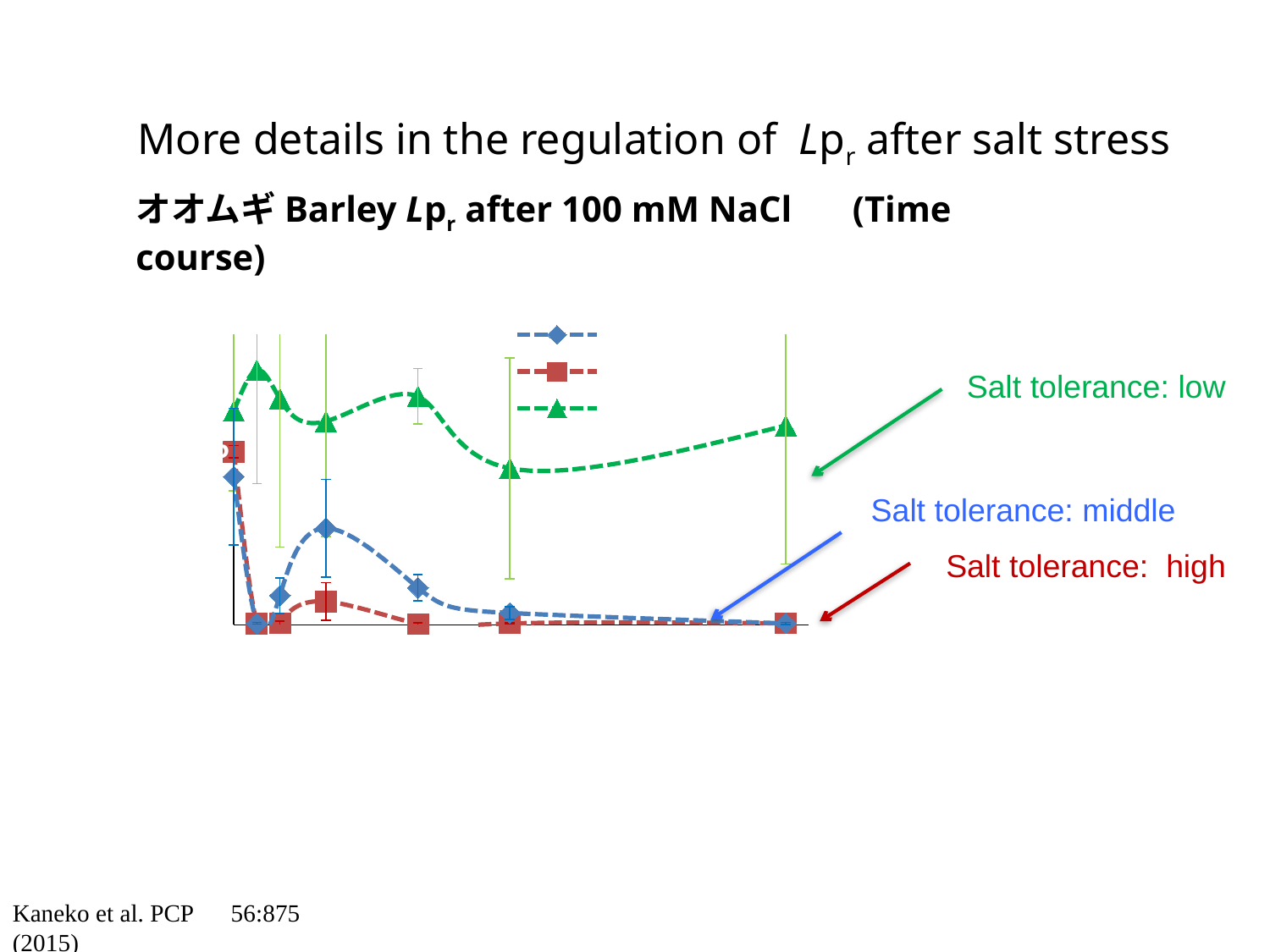
Does the blue (Salt tolerance: middle) series rise or fall overall from the first point to the last point? fall Which series (by colour) is labelled 'Salt tolerance: high'? red How many series does the legend list? 3 At the first time point, is the green series or the red series higher? green Does the red (Salt tolerance: high) series rise or fall overall from the first point to the last point? fall Which series (by colour) is labelled 'Salt tolerance: low'? green At the last time point, is the green series or the blue series higher? green Which series stays highest across the time course? green (Salt tolerance: low) What kind of chart is shown on the slide? line chart